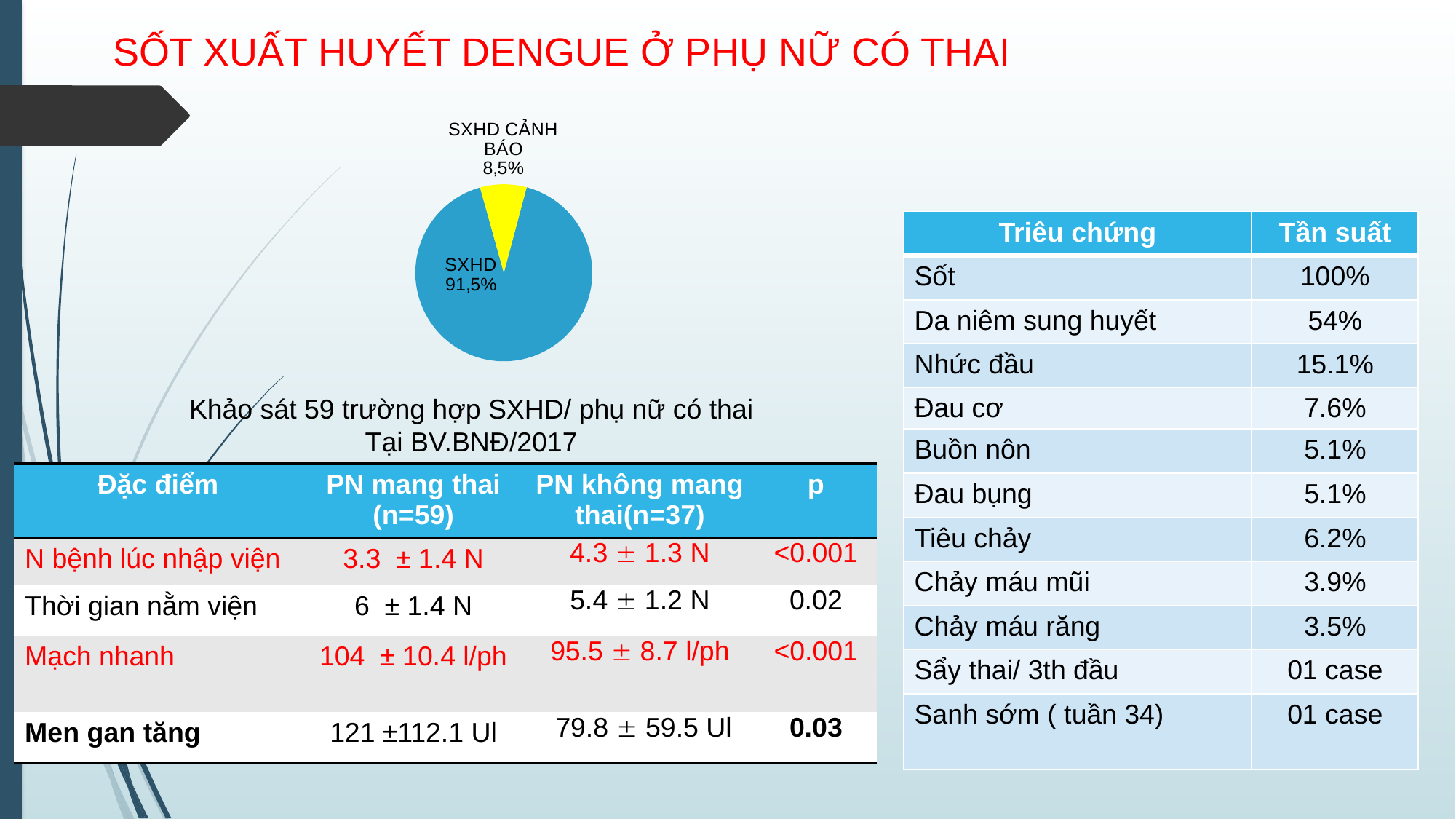
What is the difference in percentage points between the SXHD slice and the SXHD CẢNH BÁO slice? 83% Which slice of the pie chart is the largest? SXHD What share of the pie does SXHD CẢNH BÁO account for? 8,5% What colour is the SXHD slice in the pie chart? blue What colour is the SXHD CẢNH BÁO slice in the pie chart? yellow What percentage does the SXHD slice represent in the pie chart? 91,5% How many slices does the pie chart have? 2 What percentage does the SXHD CẢNH BÁO slice represent in the pie chart? 8,5% Which slice of the pie chart is the smallest? SXHD CẢNH BÁO Which is larger in the pie chart, SXHD or SXHD CẢNH BÁO? SXHD What type of chart is shown on the slide? pie chart